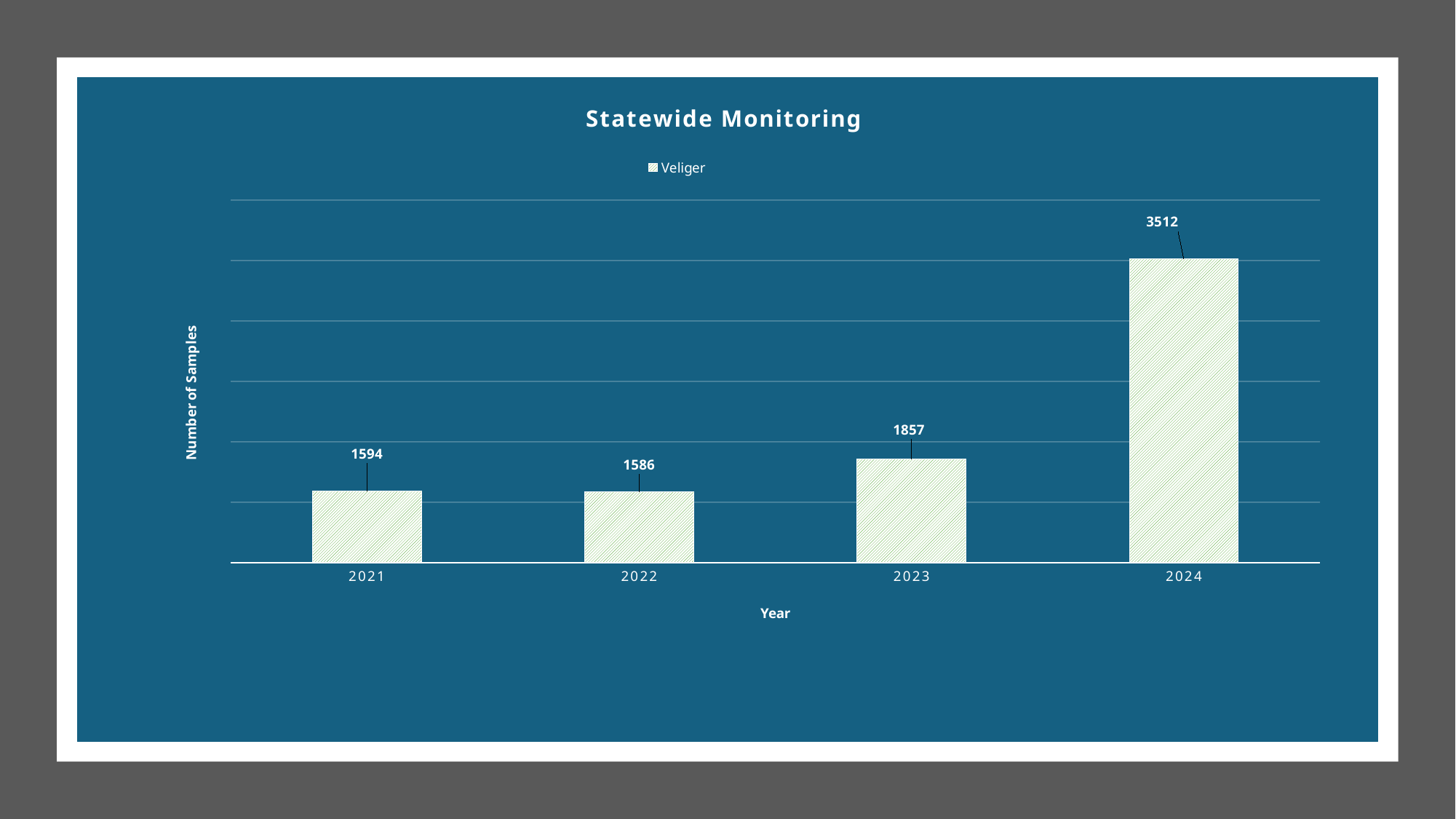
What kind of chart is shown on the slide? Bar chart What is the difference in the number of samples between 2021 and 2022? 8 What is the number of Veliger samples in 2024? 3512 Which year has the lowest number of samples? 2022 Which year has the highest number of samples? 2024 What is the number of Veliger samples in 2021? 1594 What is the number of Veliger samples in 2023? 1857 What is the title of the chart? Statewide Monitoring What is the number of Veliger samples in 2022? 1586 Which year has more samples, 2023 or 2021? 2023 How many years are shown on the x axis? 4 What is the difference in the number of samples between 2024 and 2023? 1655